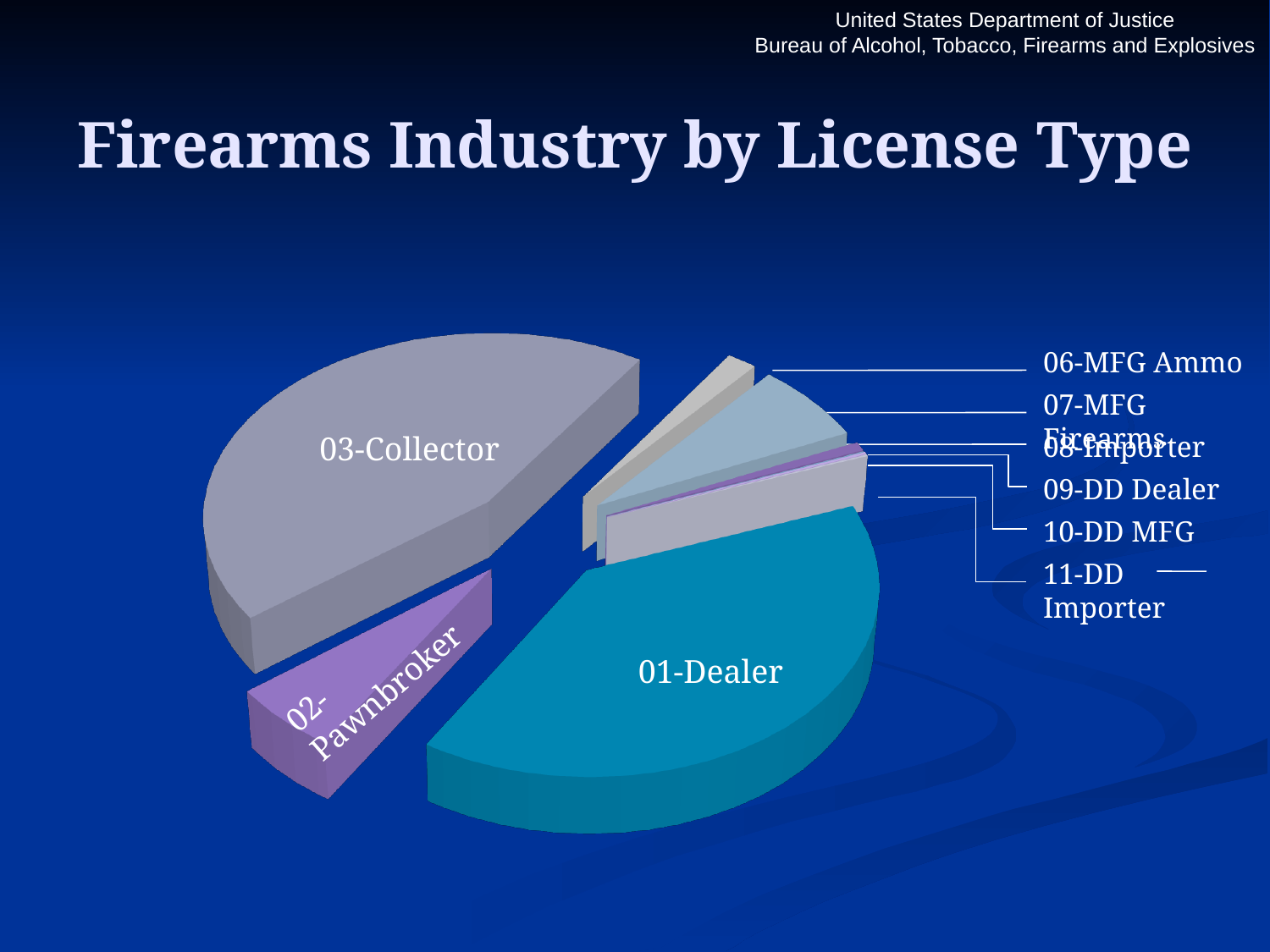
Which slice is larger, 03-Collector or 02-Pawnbroker? 03-Collector How many license-type categories are shown in the pie chart? 9 Which slice is larger, 01-Dealer or 03-Collector? 03-Collector What kind of chart is shown on the slide? pie chart Which slice is larger, 02-Pawnbroker or 07-MFG Firearms? 07-MFG Firearms Which license type has the second-largest slice of the pie? 01-Dealer Which license type has the largest slice of the pie? 03-Collector Which organization is named at the top of the slide above the chart? United States Department of Justice, Bureau of Alcohol, Tobacco, Firearms and Explosives What is the title of the chart on the slide? Firearms Industry by License Type